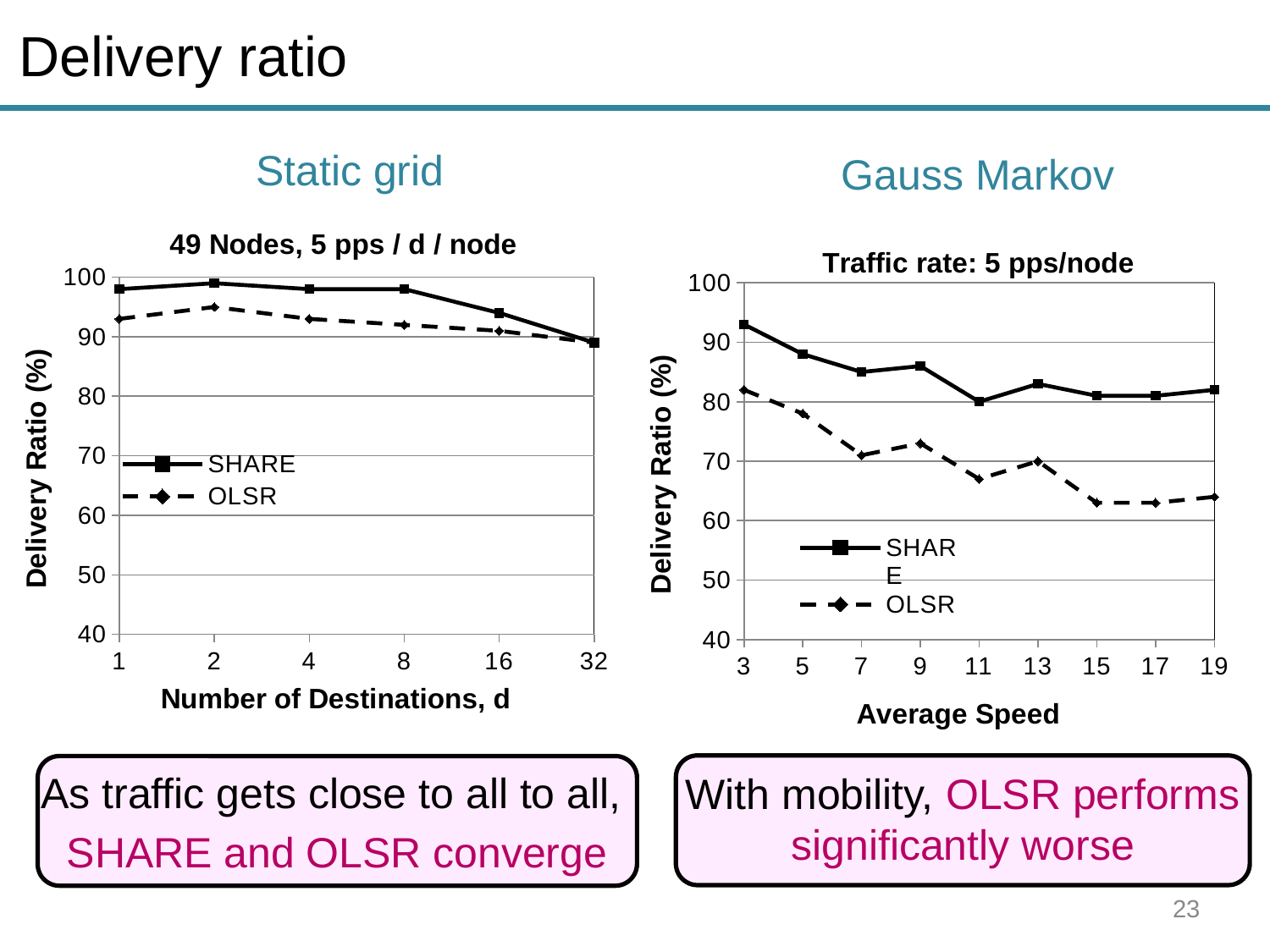
What is the title printed above the Gauss Markov chart on the right? Traffic rate: 5 pps/node In the Gauss Markov chart on the right, is the OLSR value at average speed 15 greater or less than 70? less How many series does the legend of the Gauss Markov chart on the right list? 2 In the Gauss Markov chart on the right, is the SHARE value at average speed 3 greater or less than 90? greater In the Static grid chart on the left, at which number of destinations is the SHARE delivery ratio lowest? 32 In the Static grid chart on the left, is the SHARE value at d = 2 greater or less than 90? greater In the Gauss Markov chart on the right, at which average speed is the SHARE delivery ratio highest? 3 What kind of chart is the Static grid chart on the left? line chart How many average speed values are shown on the x axis of the Gauss Markov chart on the right? 9 How many values of d are shown on the x axis of the Static grid chart on the left? 6 In the Gauss Markov chart on the right, does the OLSR delivery ratio generally rise or fall as average speed increases? fall In the Gauss Markov chart on the right, which series has the higher delivery ratio at average speed 7, SHARE or OLSR? SHARE